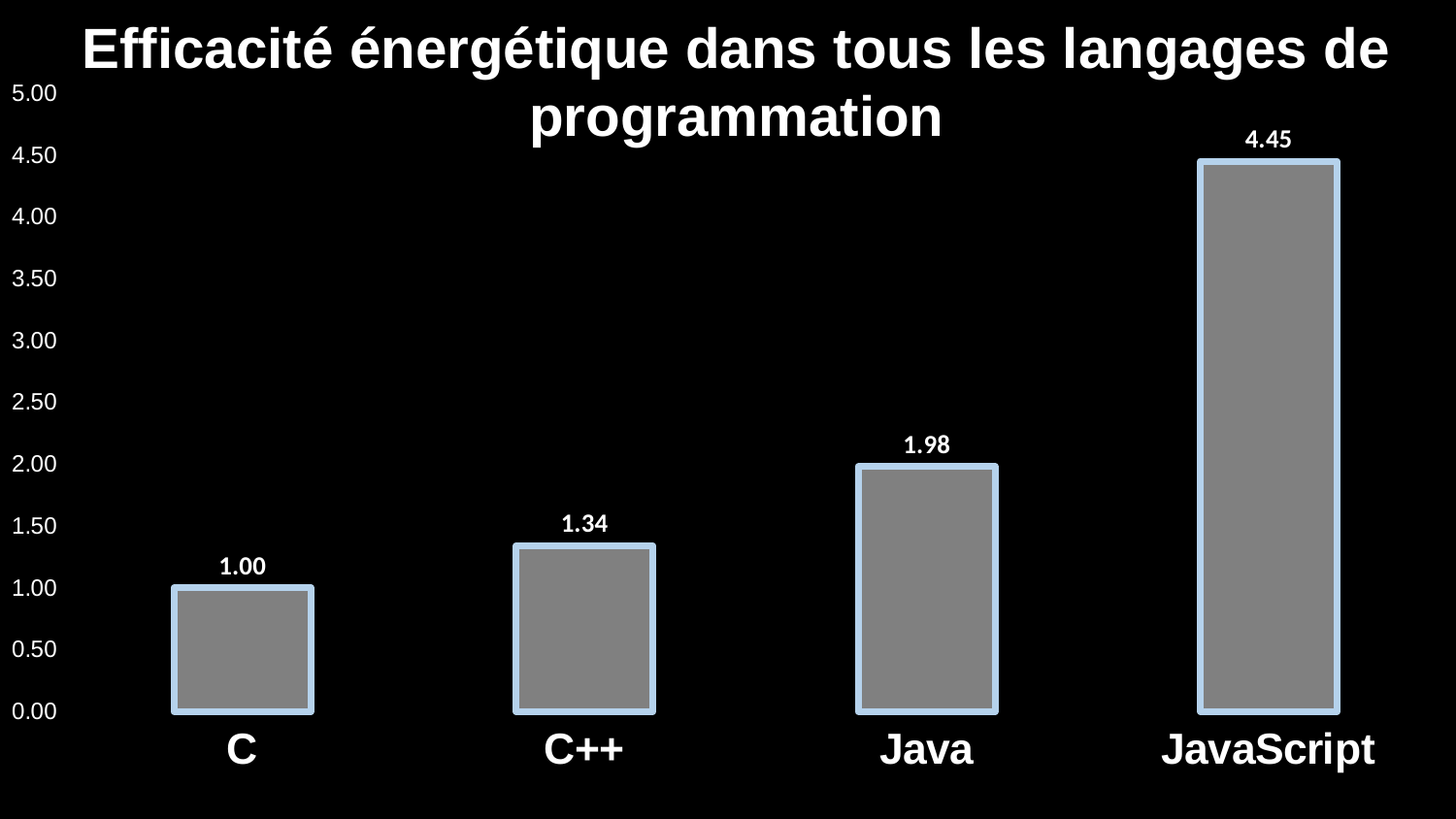
Do the values rise or fall from left to right along the x axis? Rise What kind of chart is shown on the slide? Bar chart Which language has the highest value? JavaScript Which language has the lowest value? C Is the value for JavaScript greater or less than 4.00? greater How many languages are shown on the chart? 4 Which is larger, the value for Java or the value for C++? Java What is the value for Java? 1.98 What is the value for JavaScript? 4.45 What is the value for C++? 1.34 What is the difference between the values for JavaScript and C? 3.45 What is the difference between the values for Java and C++? 0.64